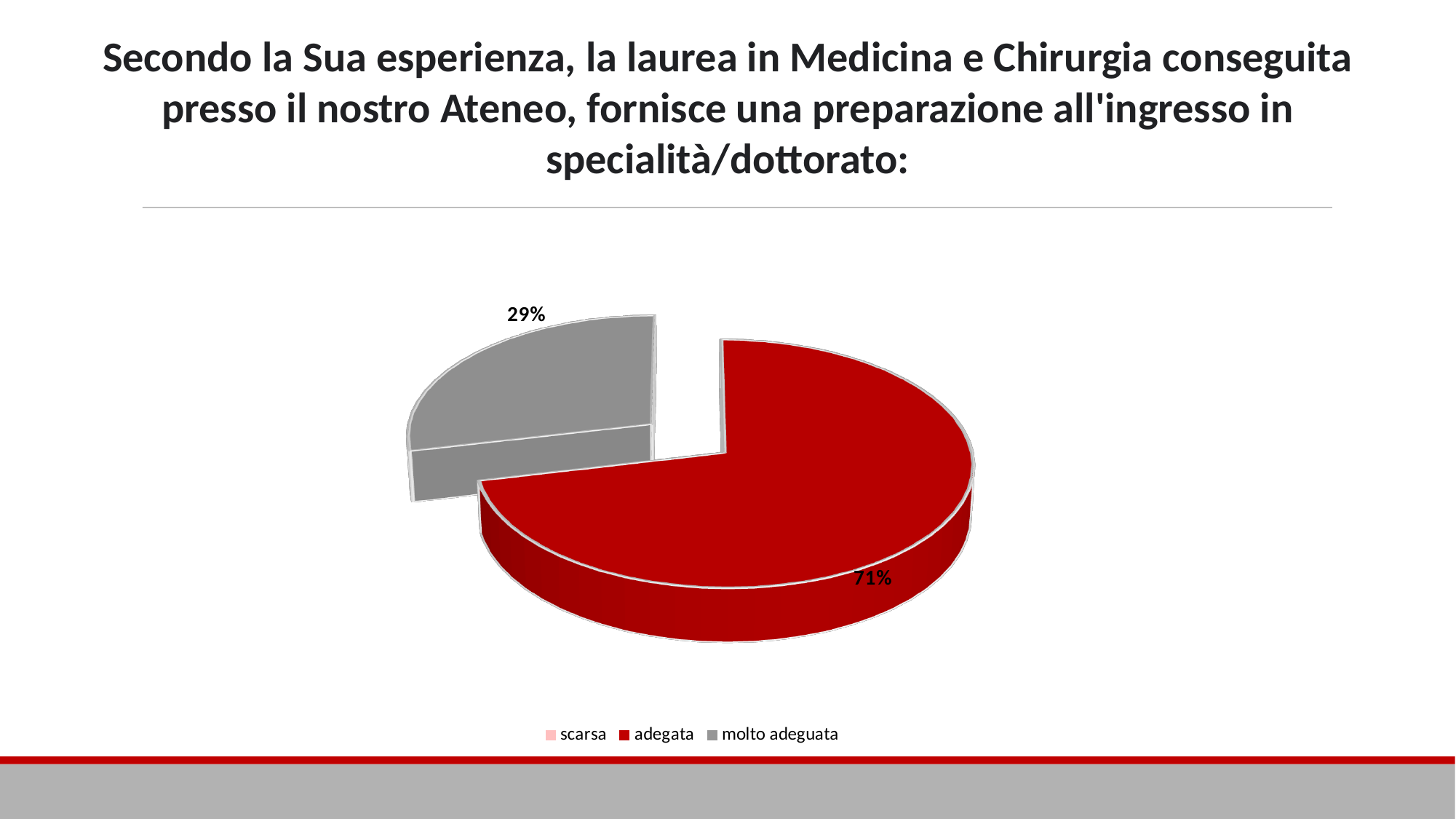
Which of the two labelled slices is larger, 'adegata' or 'molto adeguata'? adegata What share of the pie does the 'molto adeguata' slice represent? 29% What kind of chart is shown on the slide? pie chart What is the difference in percentage points between the 'adegata' slice and the 'molto adeguata' slice? 42 Is the share for 'molto adeguata' greater or less than 50%? less What share of the pie does the 'adegata' slice represent? 71% How many slices with a printed percentage label are visible in the pie? 2 Which legend entry is shown in red? adegata How many entries does the legend list? 3 Which category has the largest slice of the pie? adegata What colour is the 'molto adeguata' slice? grey